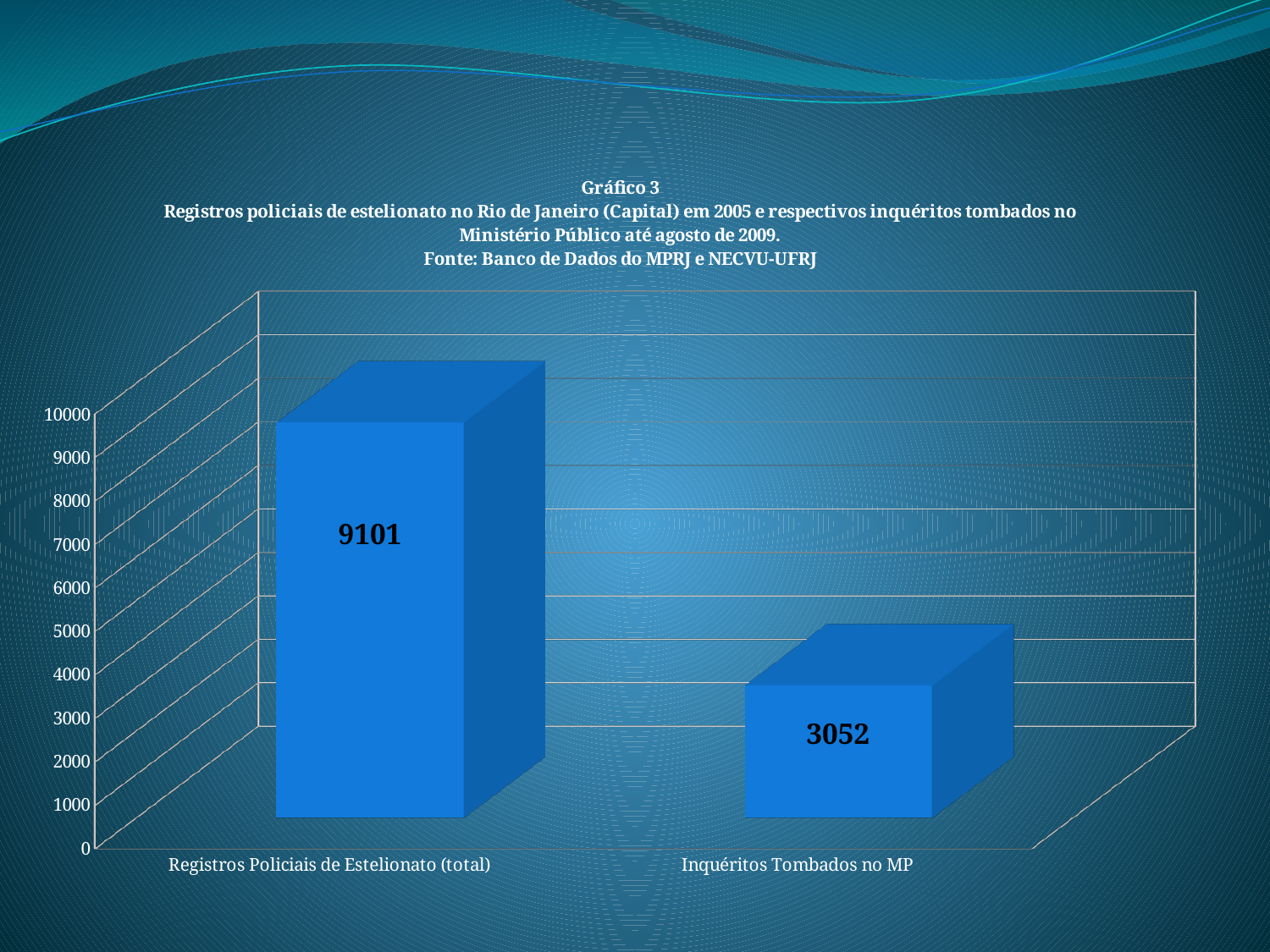
Which is larger, Registros Policiais de Estelionato (total) or Inquéritos Tombados no MP? Registros Policiais de Estelionato (total) What is the value for Inquéritos Tombados no MP? 3052 What is the maximum value shown on the vertical axis? 10000 What is the value for Registros Policiais de Estelionato (total)? 9101 Which category has the highest value? Registros Policiais de Estelionato (total) How many categories are shown in the chart? 2 Is the value for Registros Policiais de Estelionato (total) greater or less than 8000? greater Is the value for Inquéritos Tombados no MP greater or less than 4000? less Which category has the lowest value? Inquéritos Tombados no MP What is the difference between Registros Policiais de Estelionato (total) and Inquéritos Tombados no MP? 6049 What is the source cited in the chart title? Banco de Dados do MPRJ e NECVU-UFRJ What kind of chart is shown on the slide? bar chart